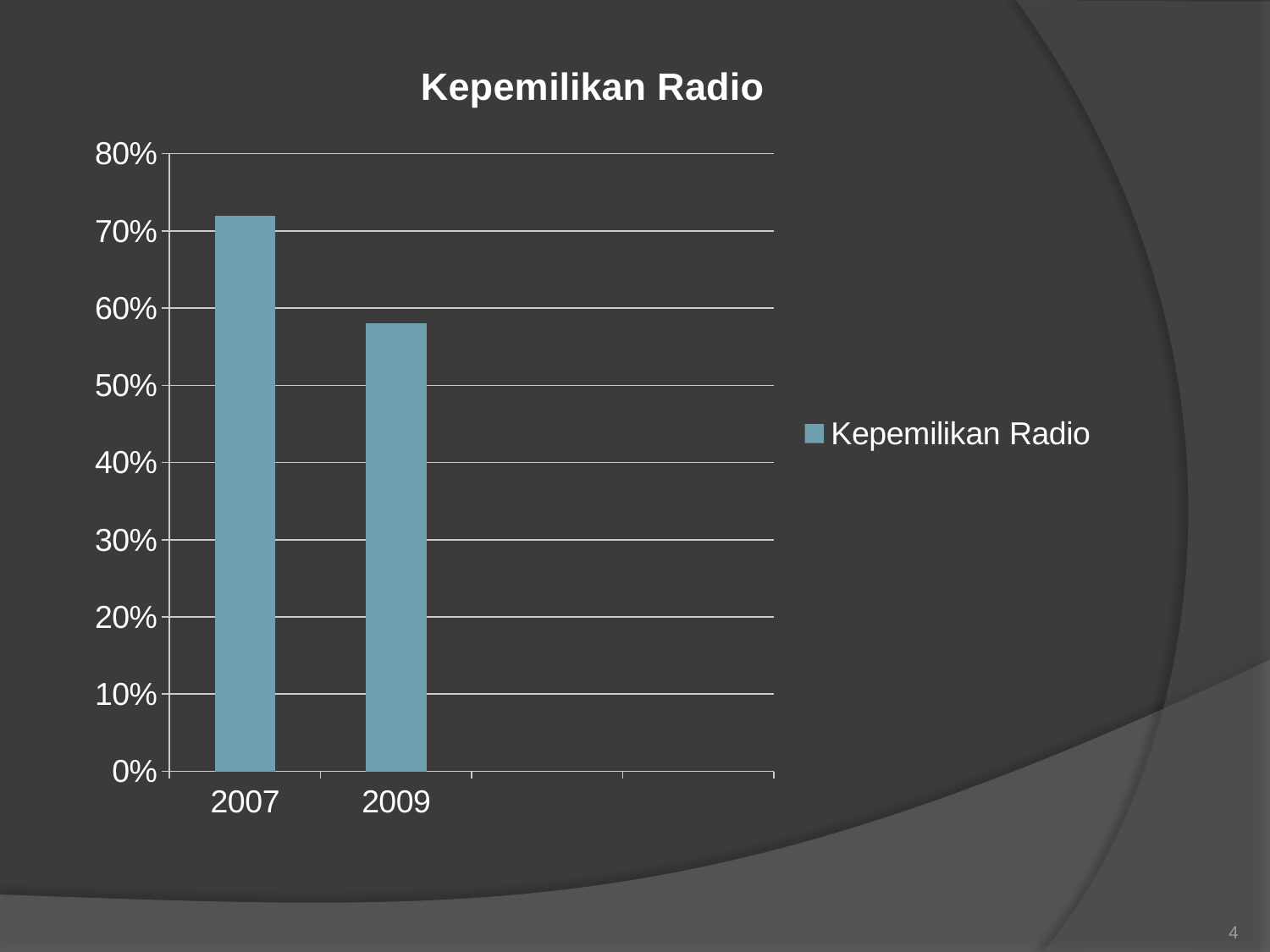
Is the value for 2009 greater or less than 50%? greater Which year has the lowest value for Kepemilikan Radio? 2009 What type of chart is shown on the slide? bar chart Which is larger, the value for 2007 or the value for 2009? 2007 Is the value for 2007 greater or less than 60%? greater Which year has the highest value for Kepemilikan Radio? 2007 What is the title of the chart? Kepemilikan Radio How many categories are shown on the x axis of the chart? 2 Is the value for 2009 greater or less than 60%? less What series name appears in the legend? Kepemilikan Radio How many series does the legend list? 1 Does the value for Kepemilikan Radio rise or fall from 2007 to 2009? fall